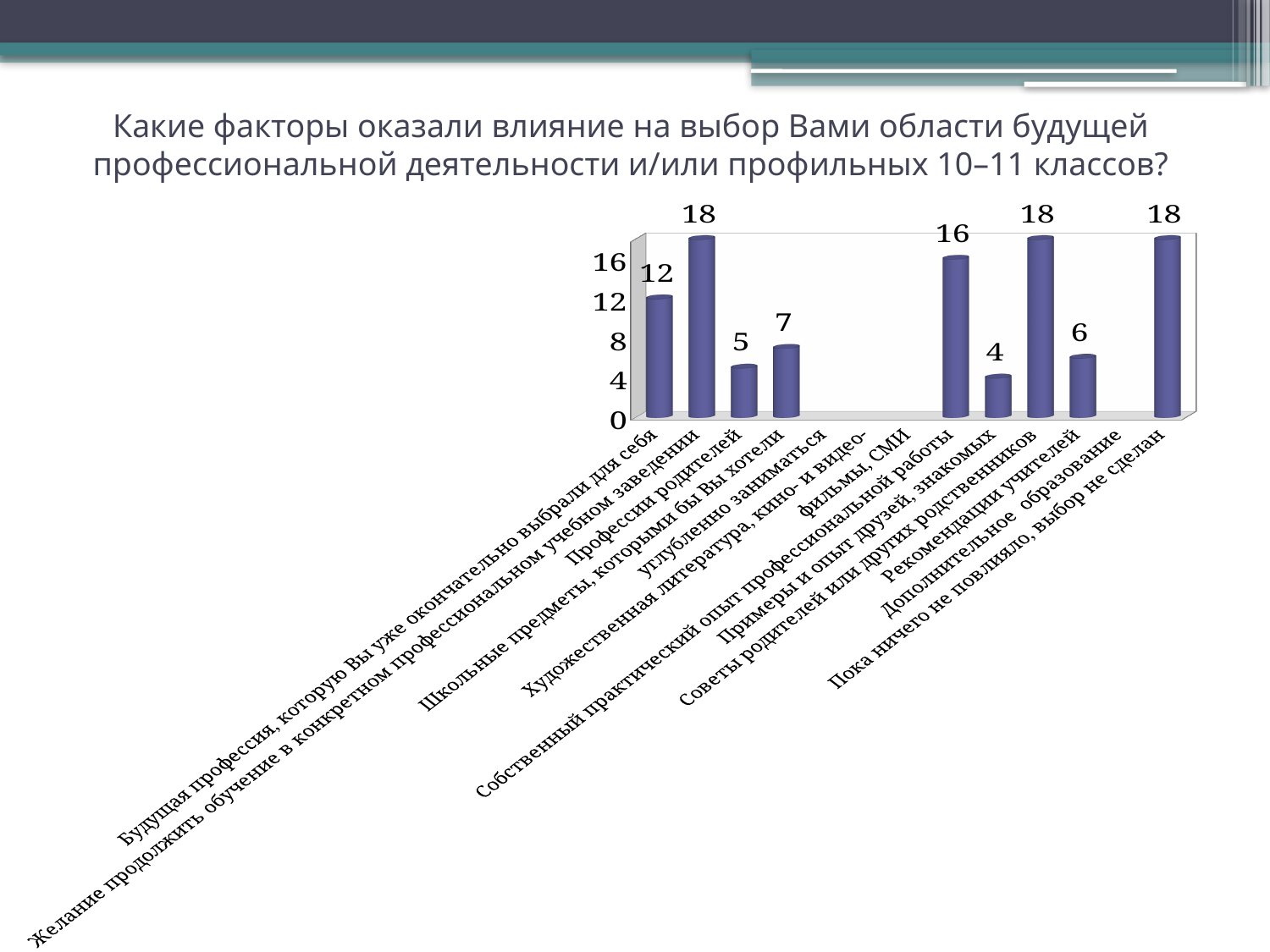
What value is shown for «Рекомендации учителей»? 6 Which labelled bar has the lowest value? Примеры и опыт друзей, знакомых Is the value for «Желание продолжить обучение в конкретном профессиональном учебном заведении» greater or less than 12? greater What is the difference between the values for «Собственный практический опыт профессиональной работы» and «Будущая профессия, которую Вы уже окончательно выбрали для себя»? 4 What value is shown for «Будущая профессия, которую Вы уже окончательно выбрали для себя»? 12 What value is shown for «Профессии родителей»? 5 Which is larger: the value for «Школьные предметы, которыми бы Вы хотели углубленно заниматься» or for «Профессии родителей»? Школьные предметы, которыми бы Вы хотели углубленно заниматься What value is shown for «Собственный практический опыт профессиональной работы»? 16 What is the highest tick value shown on the vertical axis? 16 What value is shown for «Пока ничего не повлияло, выбор не сделан»? 18 What is the difference between the values for «Советы родителей или других родственников» and «Рекомендации учителей»? 12 What kind of chart is shown on the slide? bar chart